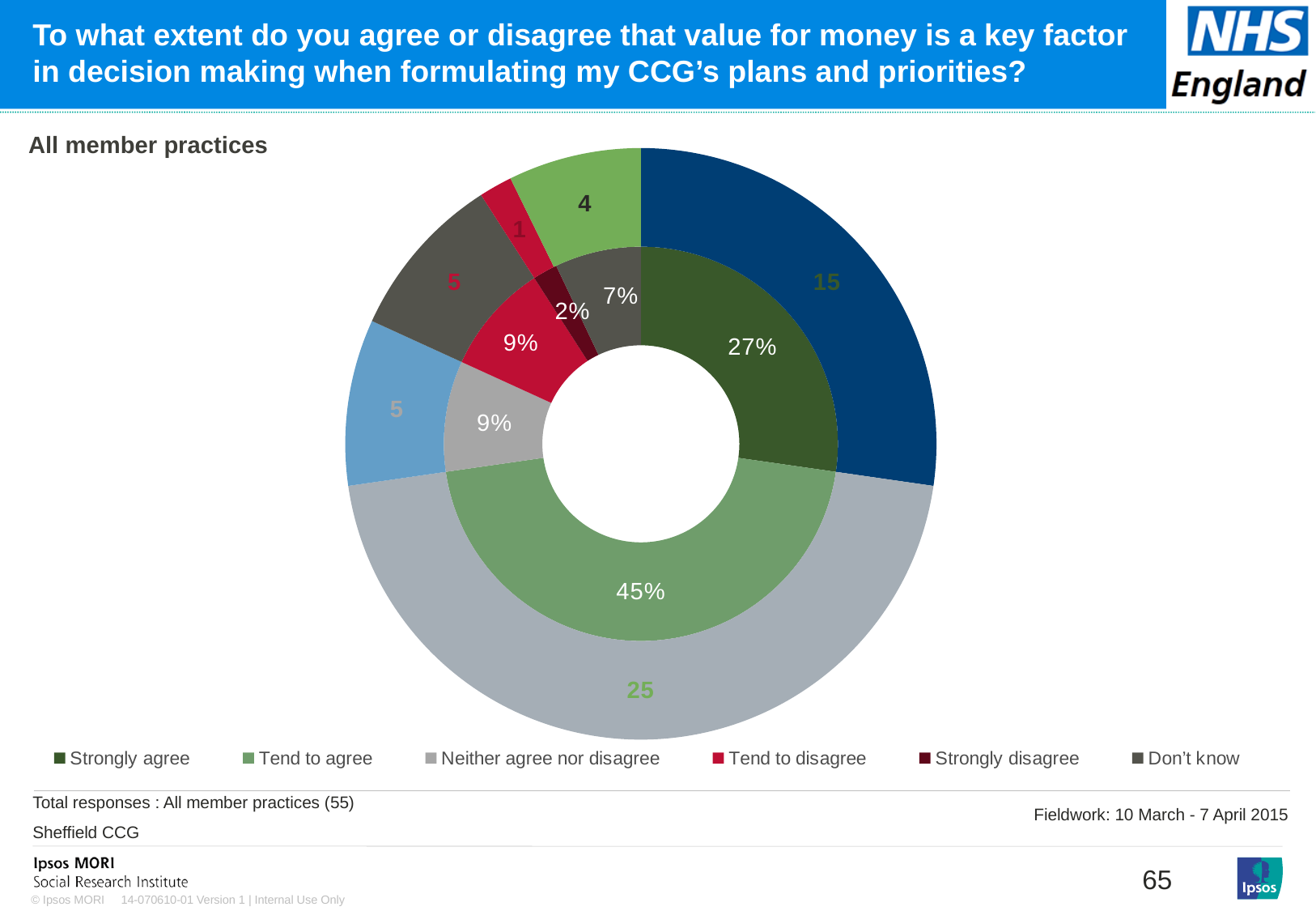
What percentage of respondents answered 'Strongly disagree'? 2% What percentage of respondents answered 'Don't know'? 7% Which response category has the largest share of the chart? Tend to agree What kind of chart is shown on the slide? Doughnut (pie) chart What percentage of respondents answered 'Strongly agree'? 27% What percentage of respondents answered 'Tend to agree'? 45% Which is larger, the share for 'Strongly agree' or the share for 'Don't know'? Strongly agree How many percentage points higher is 'Tend to agree' than 'Strongly agree'? 18 percentage points Which response category has the smallest share of the chart? Strongly disagree How many response categories does the legend list? 6 What percentage of respondents answered 'Neither agree nor disagree'? 9% What is the combined percentage for 'Strongly agree' and 'Tend to agree'? 72%